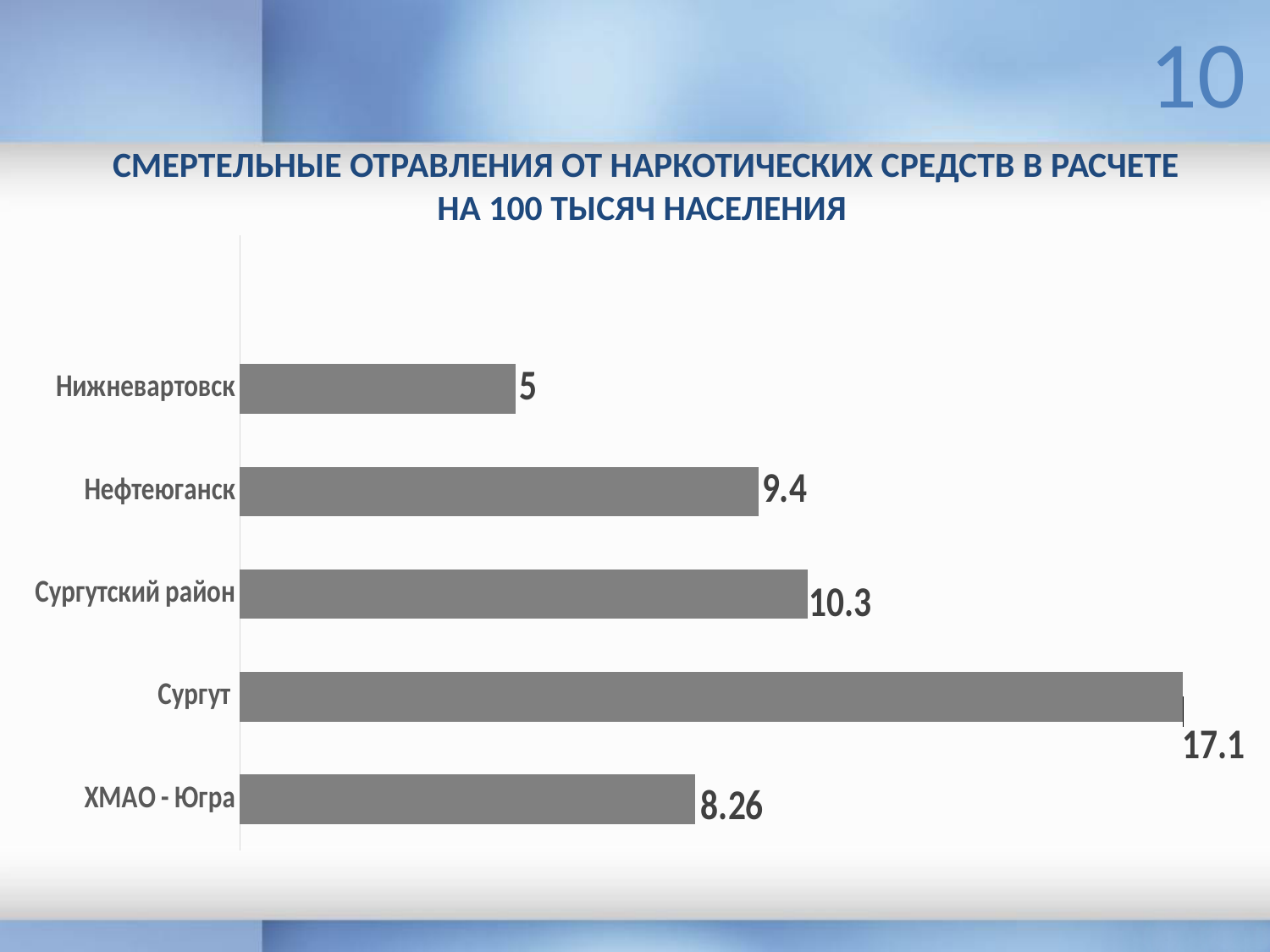
What is the value for Сургутский район? 10.3 Which category has the highest value? Сургут Which is larger, the value for Нефтеюганск or the value for ХМАО - Югра? Нефтеюганск What kind of chart is shown on the slide? Bar chart What is the difference between the values for Сургутский район and Нефтеюганск? 0.9 How many categories are shown in the chart? 5 What is the value for Нижневартовск? 5 Which category has the lowest value? Нижневартовск What is the title of the chart? СМЕРТЕЛЬНЫЕ ОТРАВЛЕНИЯ ОТ НАРКОТИЧЕСКИХ СРЕДСТВ В РАСЧЕТЕ НА 100 ТЫСЯЧ НАСЕЛЕНИЯ What is the difference between the values for Сургут and Нижневартовск? 12.1 What is the value for ХМАО - Югра? 8.26 What is the value for Сургут? 17.1